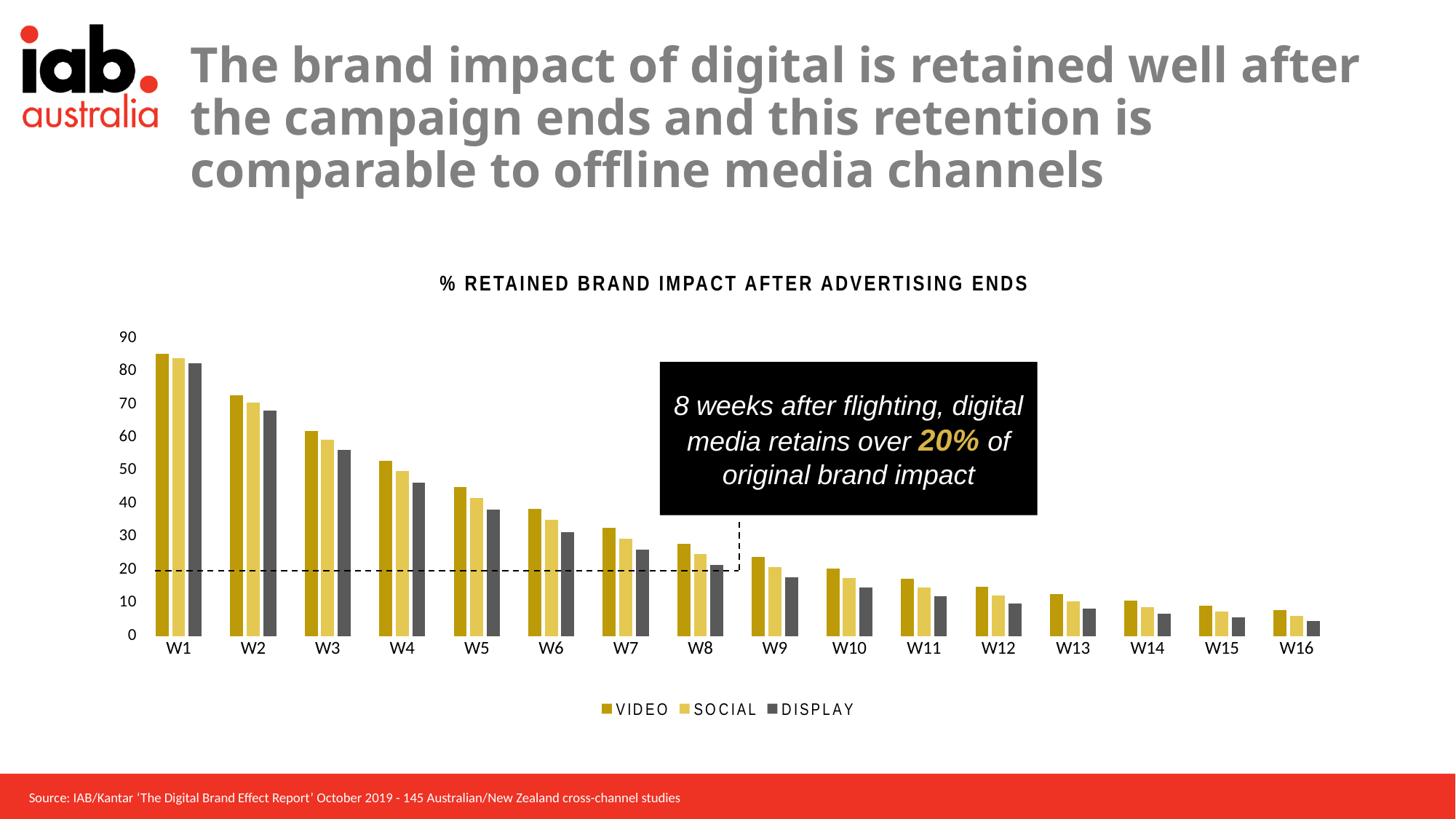
What kind of chart is shown on the slide? bar chart How many series does the legend list? 3 Is the Video value for W1 greater or less than 80? greater Is the Display value for W3 greater or less than 50? greater What is the title of the chart? % RETAINED BRAND IMPACT AFTER ADVERTISING ENDS Which week has the highest Video value? W1 Is the Display value for W8 greater or less than 30? less Do the values rise or fall from W1 to W16? fall How many weeks (categories) are shown on the x axis? 16 At W3, which is larger: the Video value or the Display value? Video Which week has the lowest Display value? W16